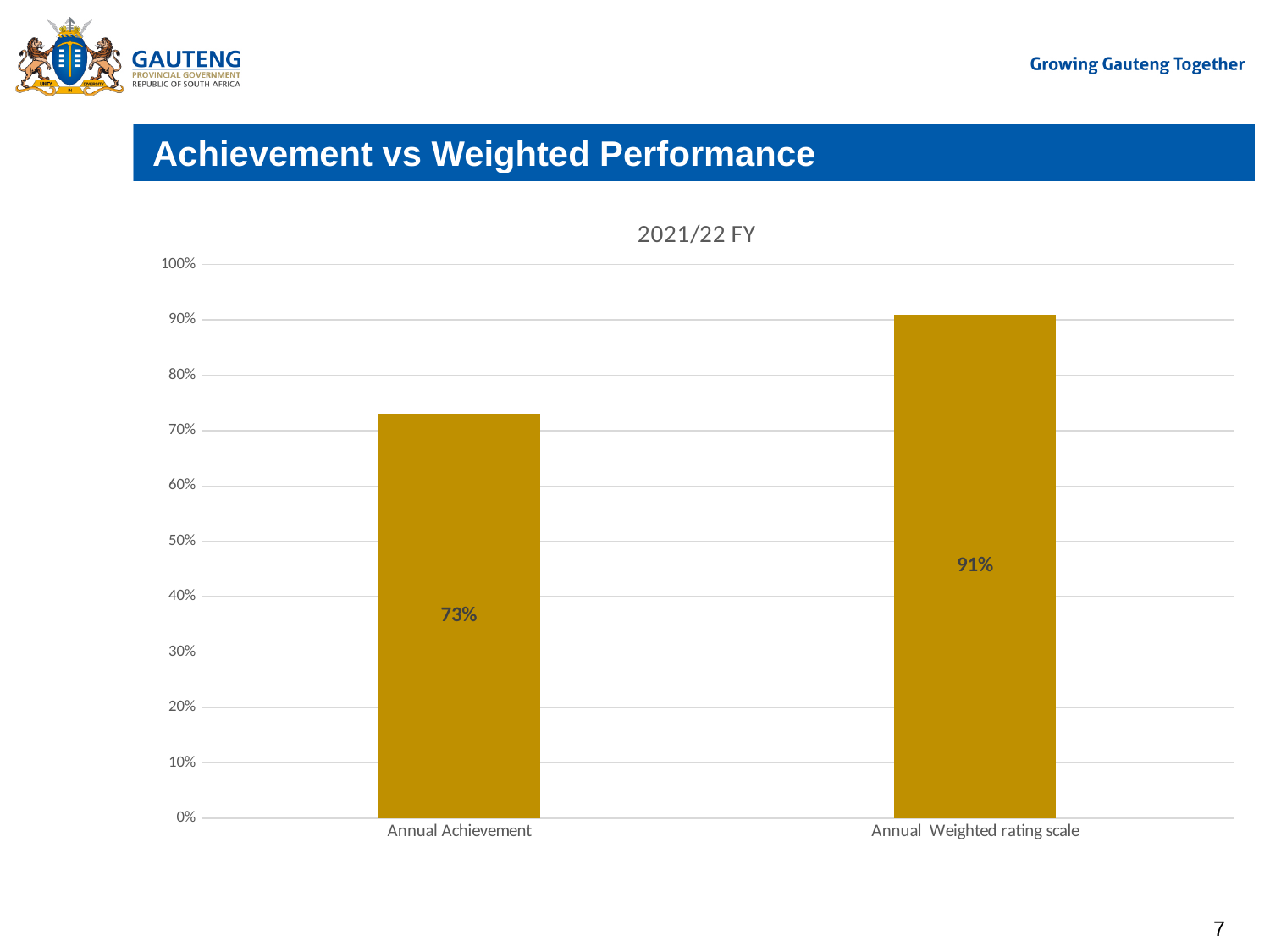
What is the value for Annual Achievement? 73% Which is larger, Annual Achievement or Annual Weighted rating scale? Annual Weighted rating scale What is the value for Annual Weighted rating scale? 91% What kind of chart is shown on the slide? bar chart Which category has the highest value? Annual Weighted rating scale Is the value for Annual Achievement greater or less than 80%? less What is the maximum value shown on the vertical axis? 100% Is the value for Annual Weighted rating scale greater or less than 90%? greater What is the difference between the Annual Weighted rating scale value and the Annual Achievement value? 18% What is the title of the chart? 2021/22 FY How many categories are shown on the chart? 2 Which category has the lowest value? Annual Achievement